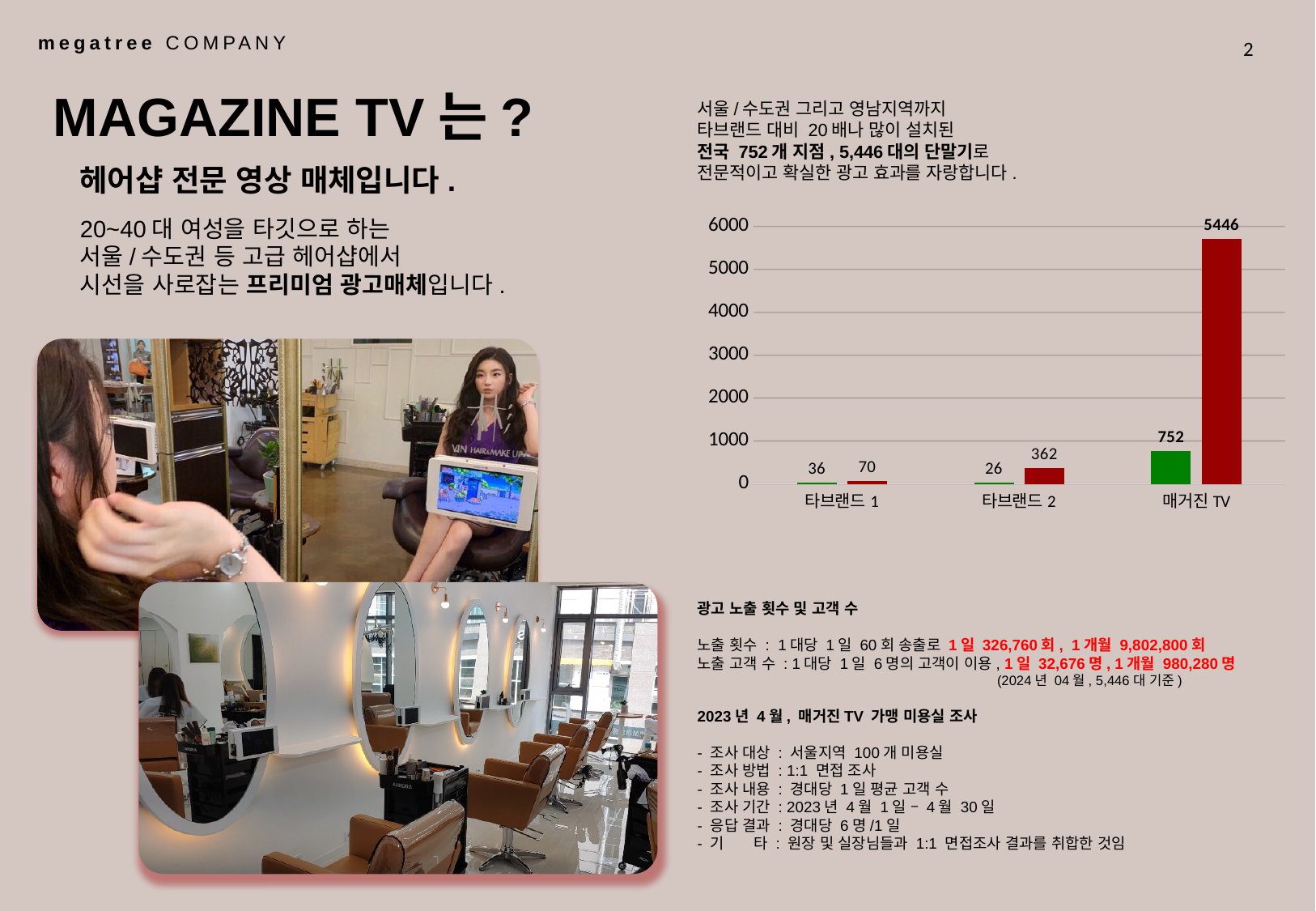
Which is larger, the green bar for 타브랜드 1 or the green bar for 타브랜드 2? 타브랜드 1 What is the highest value shown on the y axis of the chart? 6000 How many categories are shown on the x axis of the chart? 3 What is the value of the red bar for 매거진 TV? 5446 Is the red bar value for 매거진 TV greater or less than 5000? greater What is the value of the green bar for 매거진 TV? 752 What is the value of the green bar for 타브랜드 1? 36 Which category has the lowest green bar? 타브랜드 2 What is the value of the red bar for 타브랜드 2? 362 What type of chart is shown on the slide? bar chart What is the difference between the red bar values for 매거진 TV and 타브랜드 2? 5084 Which category has the highest red bar? 매거진 TV